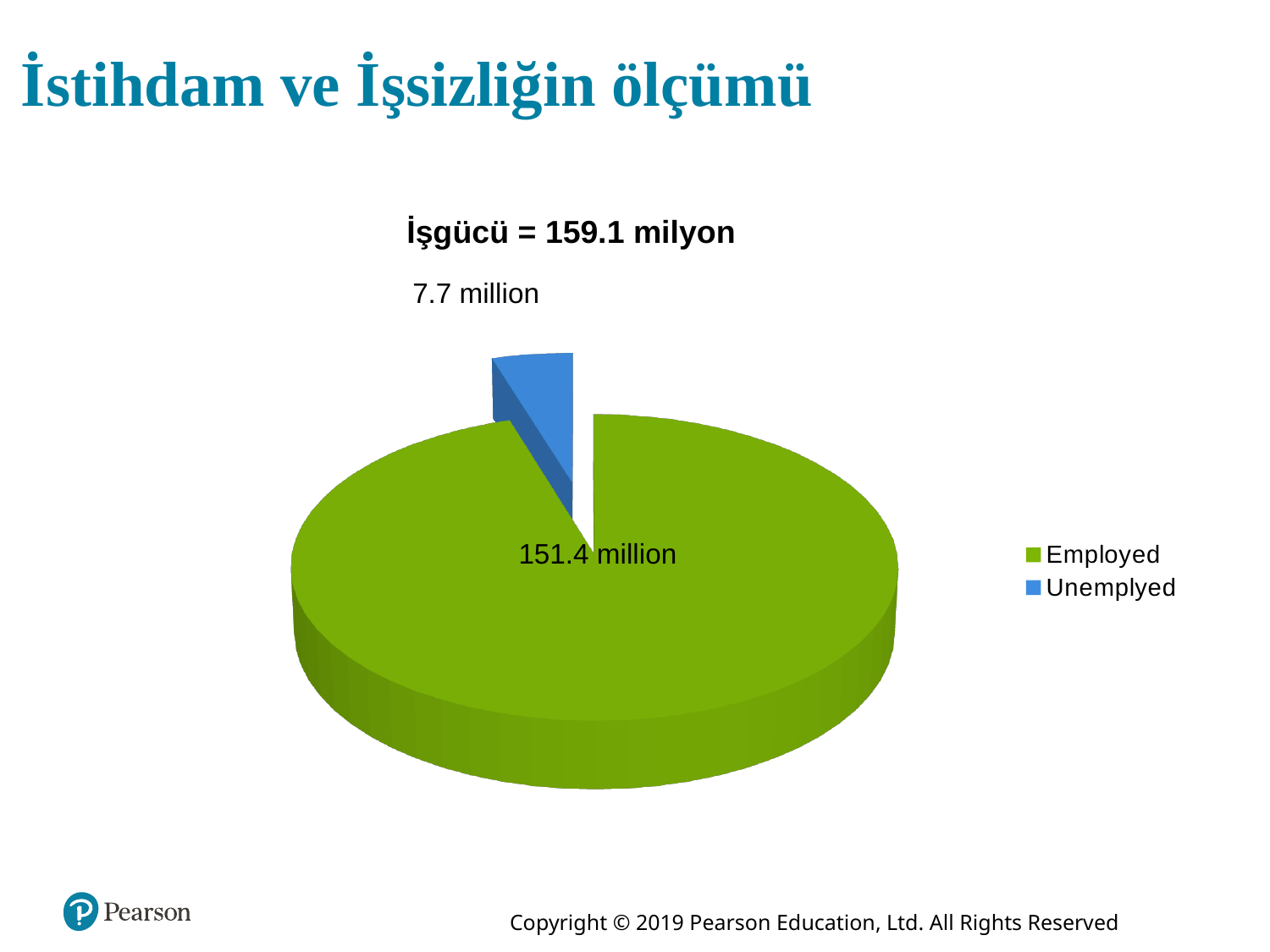
What share of the total labour force of 159.1 million is the Unemployed slice of 7.7 million, to one decimal place? 4.8% What is the value for Unemployed in the pie chart? 7.7 million How many slices does the pie chart have? 2 How many entries does the legend list? 2 What total labour force (İşgücü) is stated in the chart title? 159.1 milyon Which slice of the pie chart is the largest? Employed Which slice of the pie chart is the smallest? Unemployed What colour is the Employed slice in the pie chart? green What kind of chart is shown on the slide? pie chart What is the value for Employed in the pie chart? 151.4 million Which is larger, the Employed slice or the Unemployed slice? Employed What is the difference between the Employed value and the Unemployed value? 143.7 million